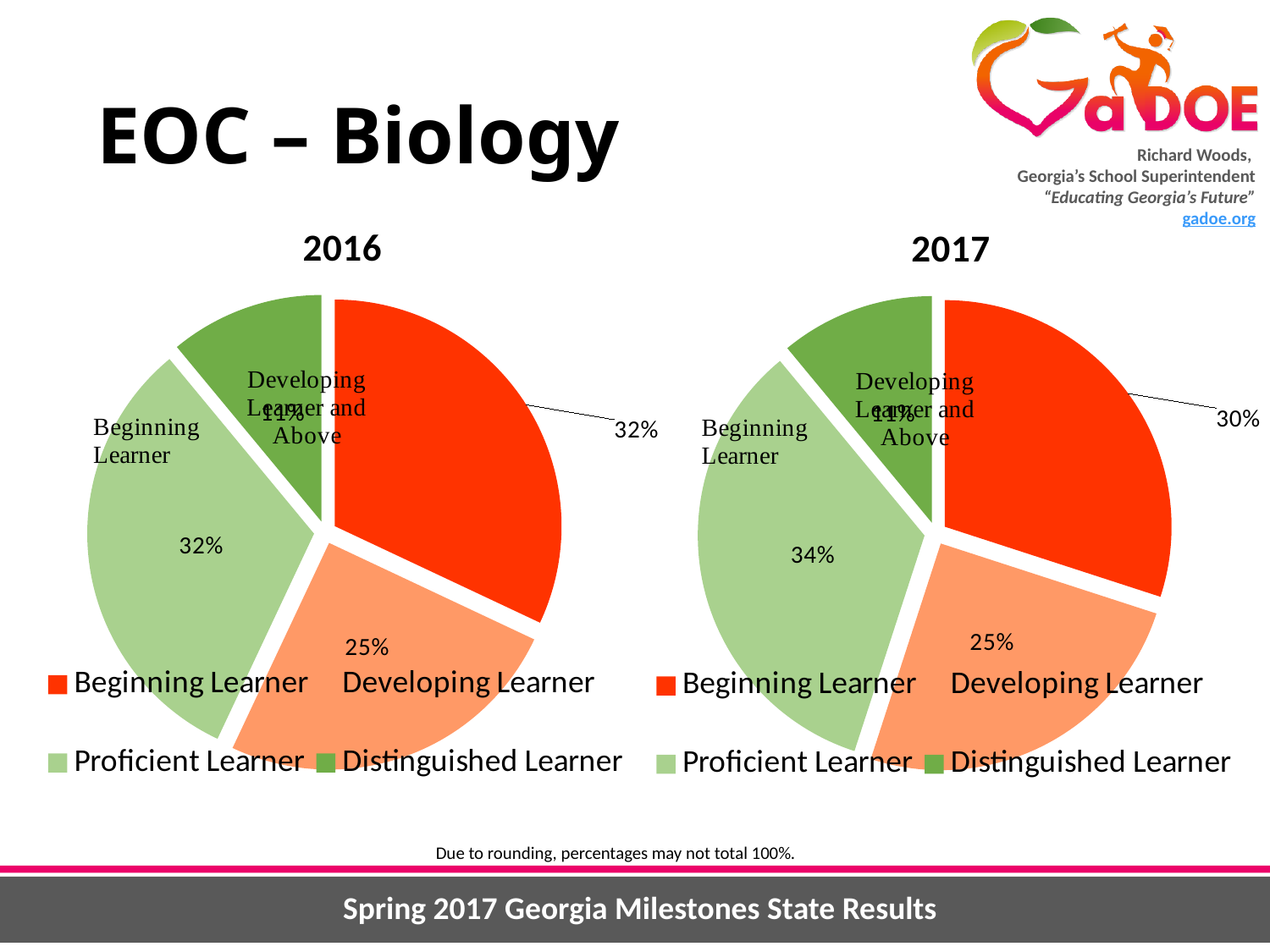
In the 2017 chart, what is the difference between the Proficient Learner and Beginning Learner percentages? 4% In the 2017 chart, which category has the largest share? Proficient Learner In the 2017 chart, what percentage is shown for Developing Learner? 25% In the 2017 chart, which is larger: Developing Learner or Distinguished Learner? Developing Learner In the 2016 chart, which category has the smallest share? Distinguished Learner How many categories does the legend of the 2016 chart list? 4 What type of charts are shown on the slide? Pie charts In the 2017 chart, what percentage is shown for Beginning Learner? 30% In the 2016 chart, what percentage is shown for Distinguished Learner? 11% In the 2016 chart, what percentage is shown for Developing Learner? 25% In the 2017 chart, what percentage is shown for Proficient Learner? 34% Which colour represents Beginning Learner in the legends? Red